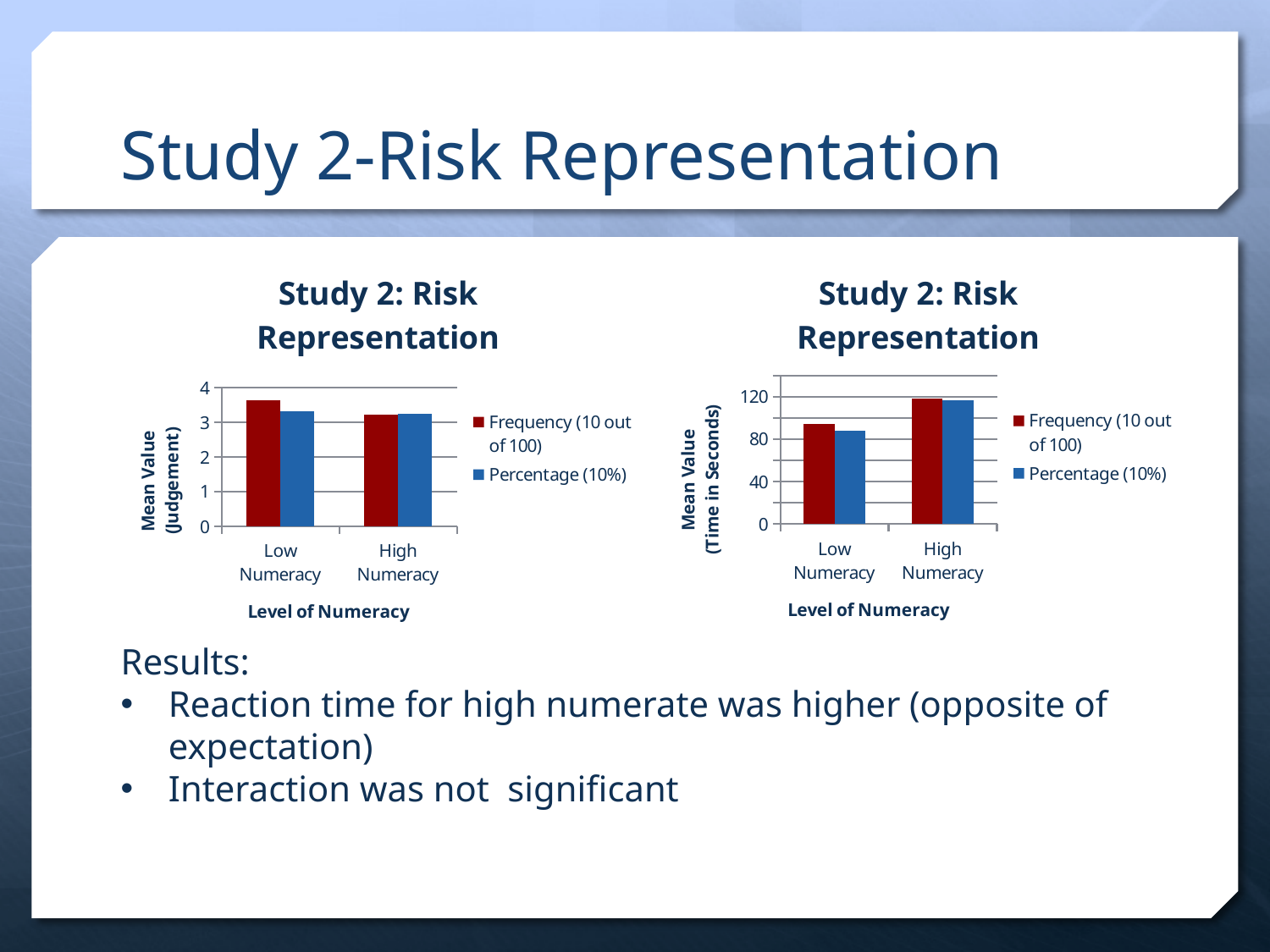
In the left chart (Mean Value (Judgement)), which series has the larger value for Low Numeracy, Frequency (10 out of 100) or Percentage (10%)? Frequency (10 out of 100) How many series does the legend of the right chart (Mean Value (Time in Seconds)) list? 2 In the right chart (Mean Value (Time in Seconds)), which series has the larger value for Low Numeracy, Frequency (10 out of 100) or Percentage (10%)? Frequency (10 out of 100) In the right chart (Mean Value (Time in Seconds)), which bar is the lowest? Percentage (10%) for Low Numeracy What is the x-axis title of the right chart (Mean Value (Time in Seconds))? Level of Numeracy How many categories are shown on the x axis of the left chart (Mean Value (Judgement))? 2 In the left chart (Mean Value (Judgement)), is the Frequency (10 out of 100) value for Low Numeracy greater or less than 3? greater In the left chart (Mean Value (Judgement)), which bar is the highest? Frequency (10 out of 100) for Low Numeracy What kind of chart is the left chart (Mean Value (Judgement))? bar chart In the right chart (Mean Value (Time in Seconds)), is the Frequency (10 out of 100) value for Low Numeracy greater or less than 80? greater In the right chart (Mean Value (Time in Seconds)), is the Percentage (10%) value for High Numeracy greater or less than 80? greater In the left chart (Mean Value (Judgement)), does the Frequency (10 out of 100) value rise or fall from Low Numeracy to High Numeracy? fall